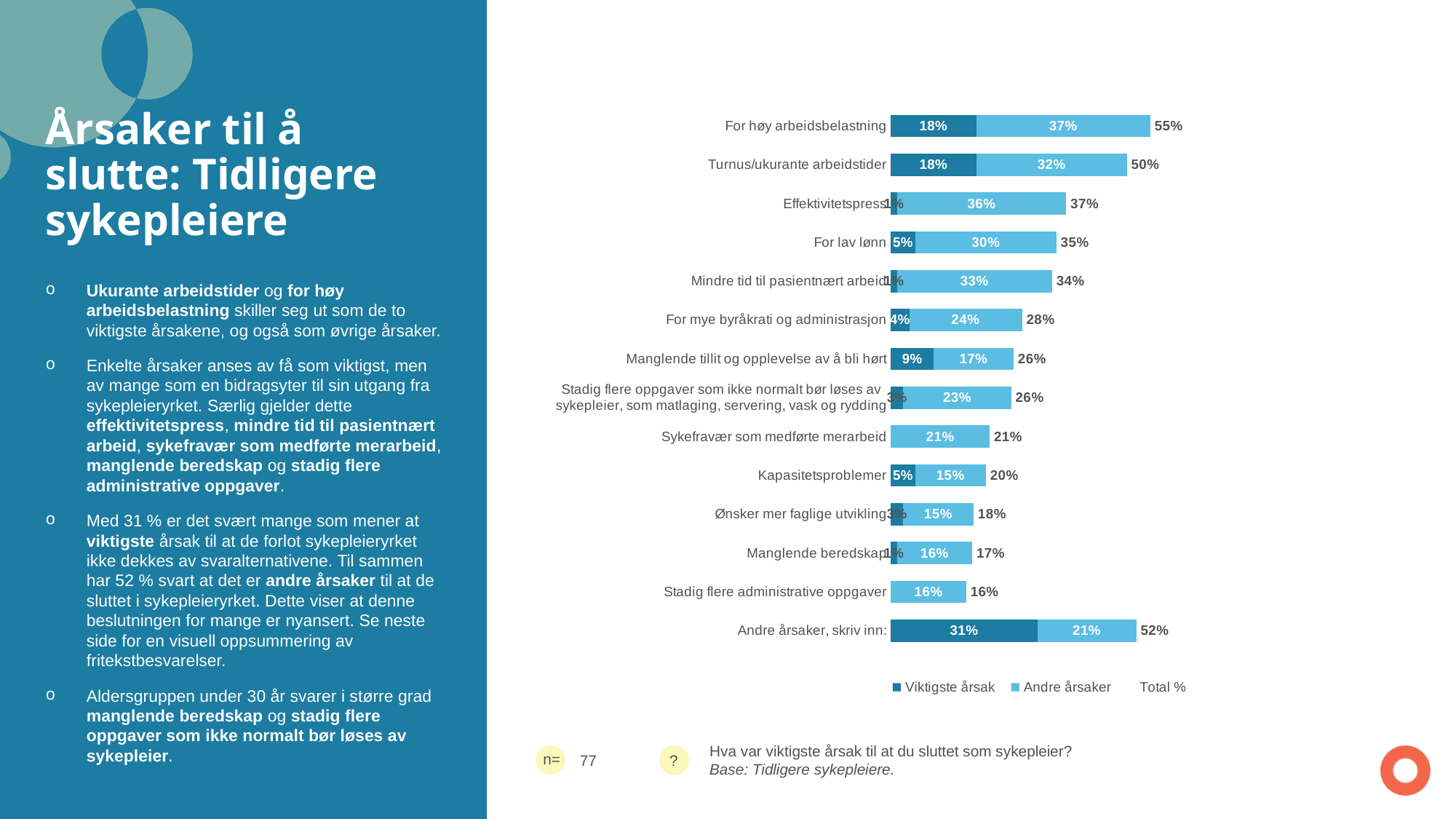
What is the difference between the total percentages for 'For høy arbeidsbelastning' and 'Turnus/ukurante arbeidstider'? 5% What kind of chart is shown on the slide? Stacked bar chart What is the 'Viktigste årsak' value for 'Andre årsaker, skriv inn:'? 31% Which category has the lowest total percentage? Stadig flere administrative oppgaver Which is larger: the 'Andre årsaker' value for 'Effektivitetspress' or for 'Mindre tid til pasientnært arbeid'? Effektivitetspress What is the total of the stacked bar for 'Manglende tillit og opplevelse av å bli hørt'? 26% What is the total percentage shown for 'For lav lønn'? 35% What is the 'Viktigste årsak' value for 'For høy arbeidsbelastning'? 18% What is the 'Andre årsaker' value for 'Turnus/ukurante arbeidstider'? 32% Which category has the highest total percentage? For høy arbeidsbelastning Which category has the highest 'Viktigste årsak' value? Andre årsaker, skriv inn: How many categories are shown in the chart? 14